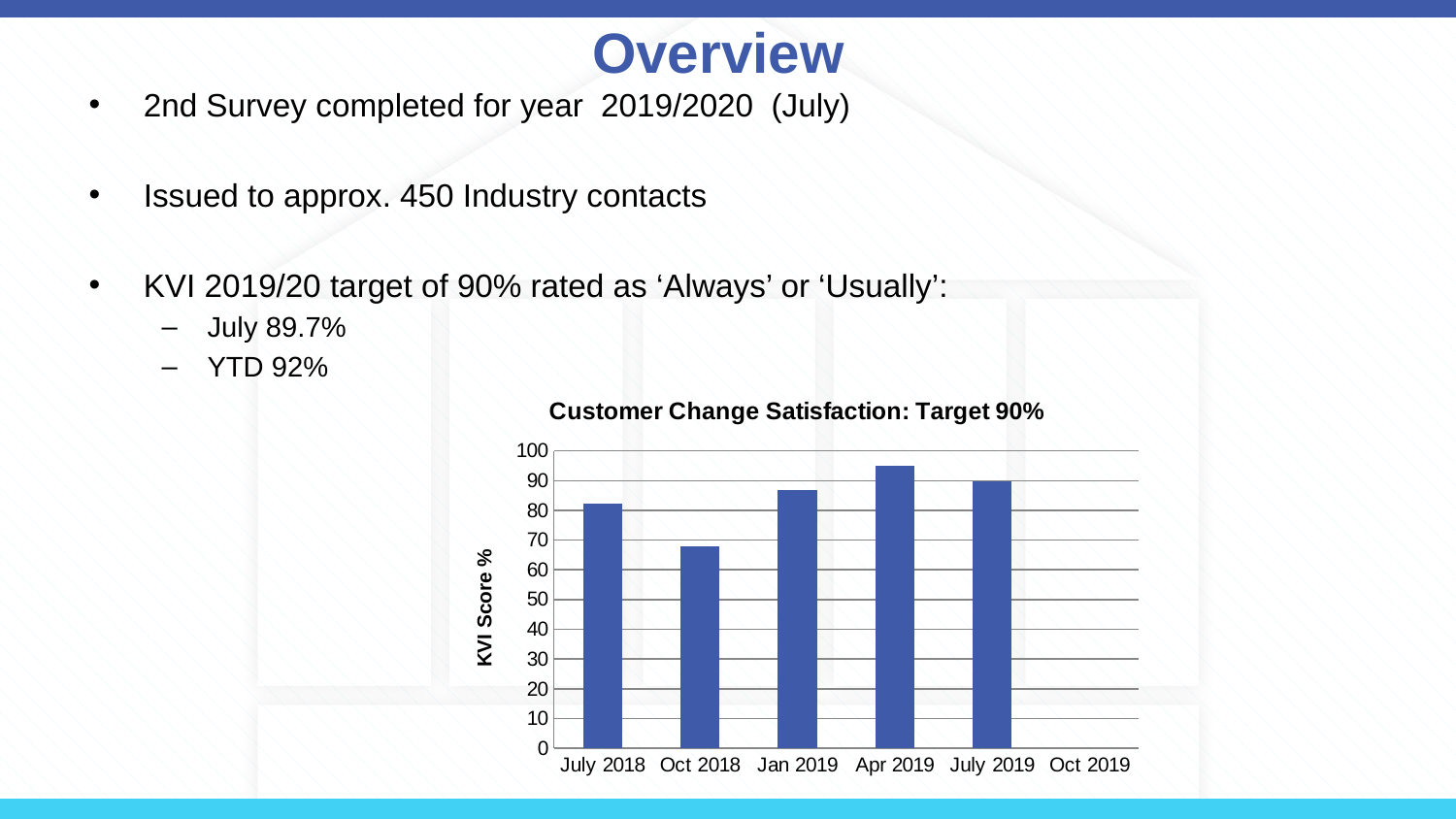
What is the title of the chart? Customer Change Satisfaction: Target 90% Which period has the lowest KVI score in the chart? Oct 2018 What kind of chart is shown on the slide? Bar chart What is the label on the vertical axis of the chart? KVI Score % Which period on the x axis has no bar plotted? Oct 2019 Is the KVI score for July 2018 greater or less than 80? greater Is the KVI score for Apr 2019 greater or less than 90? greater Is the KVI score for Oct 2018 greater or less than 70? less Do the KVI scores rise or fall from Oct 2018 to Apr 2019? rise Which has the higher KVI score, Jan 2019 or Oct 2018? Jan 2019 Which period has the highest KVI score in the chart? Apr 2019 How many bars are plotted in the chart? 5